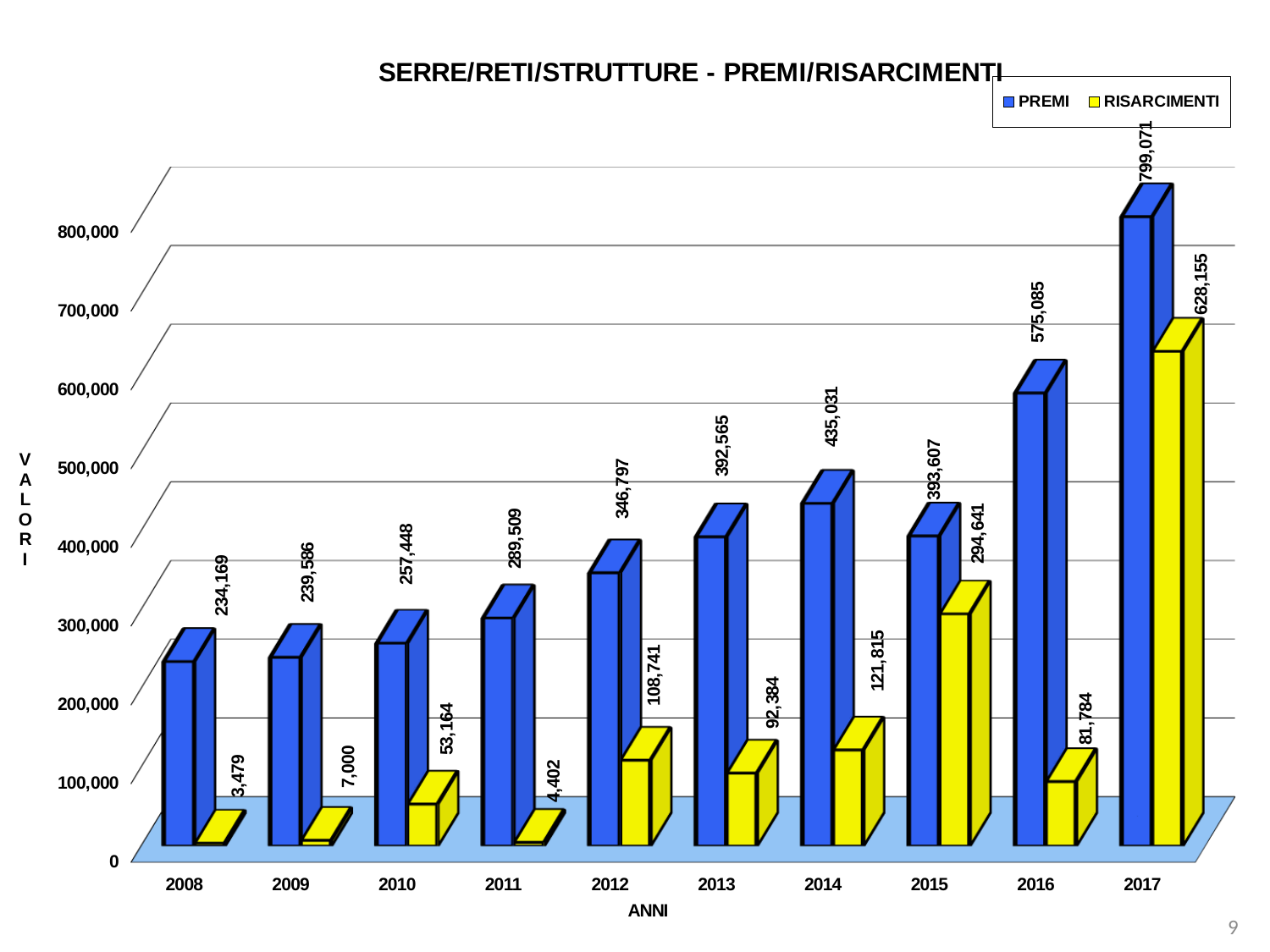
What is the PREMI value for 2014? 435,031 How many years are shown on the x axis? 10 Which year has the larger PREMI value, 2013 or 2015? 2015 How many series does the legend list? 2 Which year has the highest PREMI value? 2017 Which year has the lowest RISARCIMENTI value? 2008 What is the difference between PREMI and RISARCIMENTI in 2016? 493,301 What is the RISARCIMENTI value for 2015? 294,641 What kind of chart is shown on the slide? bar chart Do the PREMI values rise or fall from 2008 to 2014? rise What is the RISARCIMENTI value for 2011? 4,402 What is the difference between PREMI and RISARCIMENTI in 2017? 170,916